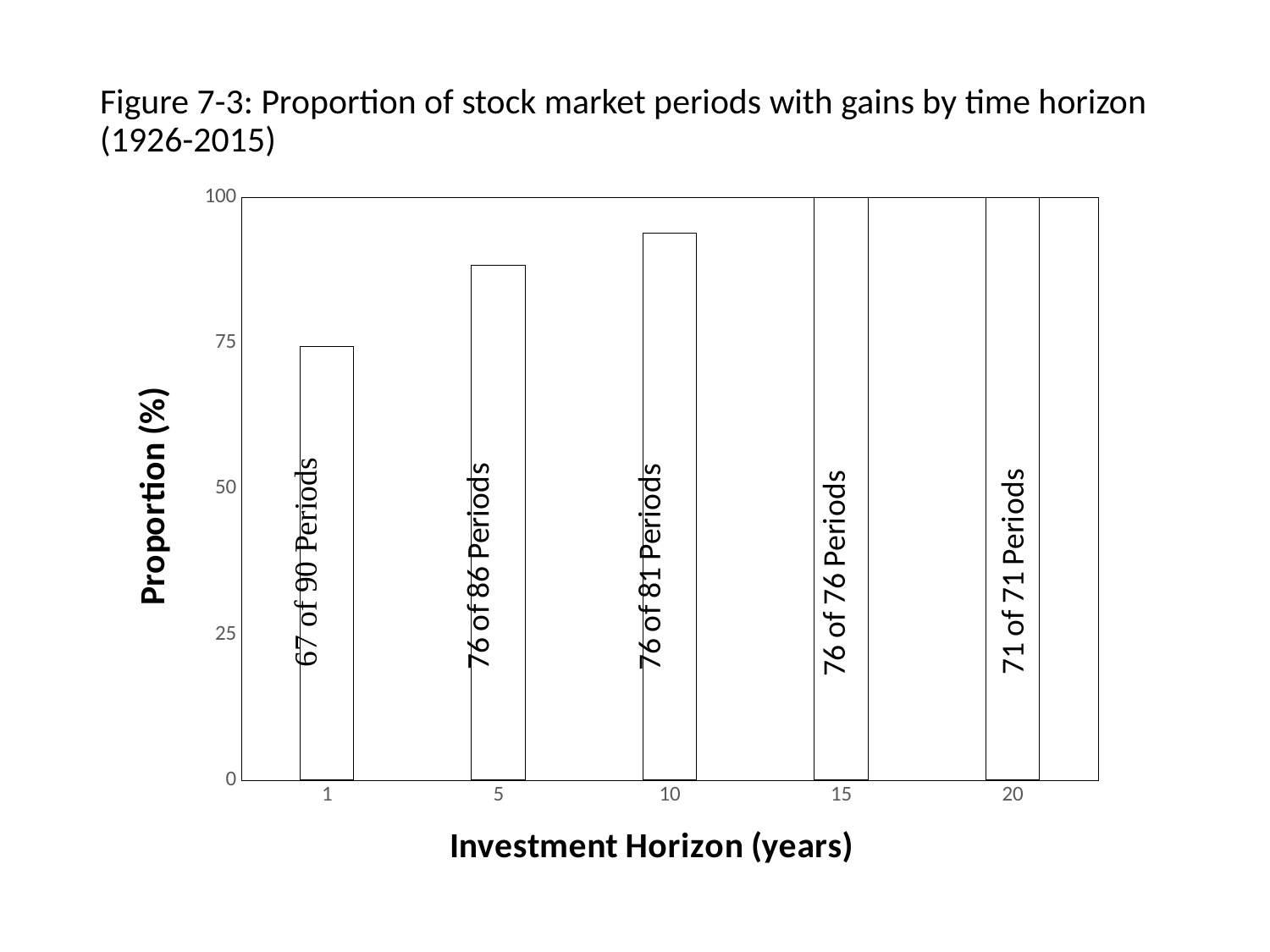
Is the proportion for the 5-year investment horizon greater or less than 75? greater What label is printed on the bar for the 20-year investment horizon? 71 of 71 Periods What is the label of the x axis? Investment Horizon (years) Which investment horizon has the lowest proportion of periods with gains? 1 Is the proportion for the 10-year investment horizon greater or less than 100? less What label is printed on the bar for the 10-year investment horizon? 76 of 81 Periods What kind of chart is shown on the slide? bar chart What label is printed on the bar for the 1-year investment horizon? 67 of 90 Periods Which has a higher proportion of periods with gains, the 5-year or the 10-year horizon? 10-year What proportion (%) is shown for the 15-year investment horizon? 100 Do the proportions rise or fall as the investment horizon increases from 1 to 15 years? rise How many investment horizons are plotted on the x axis? 5